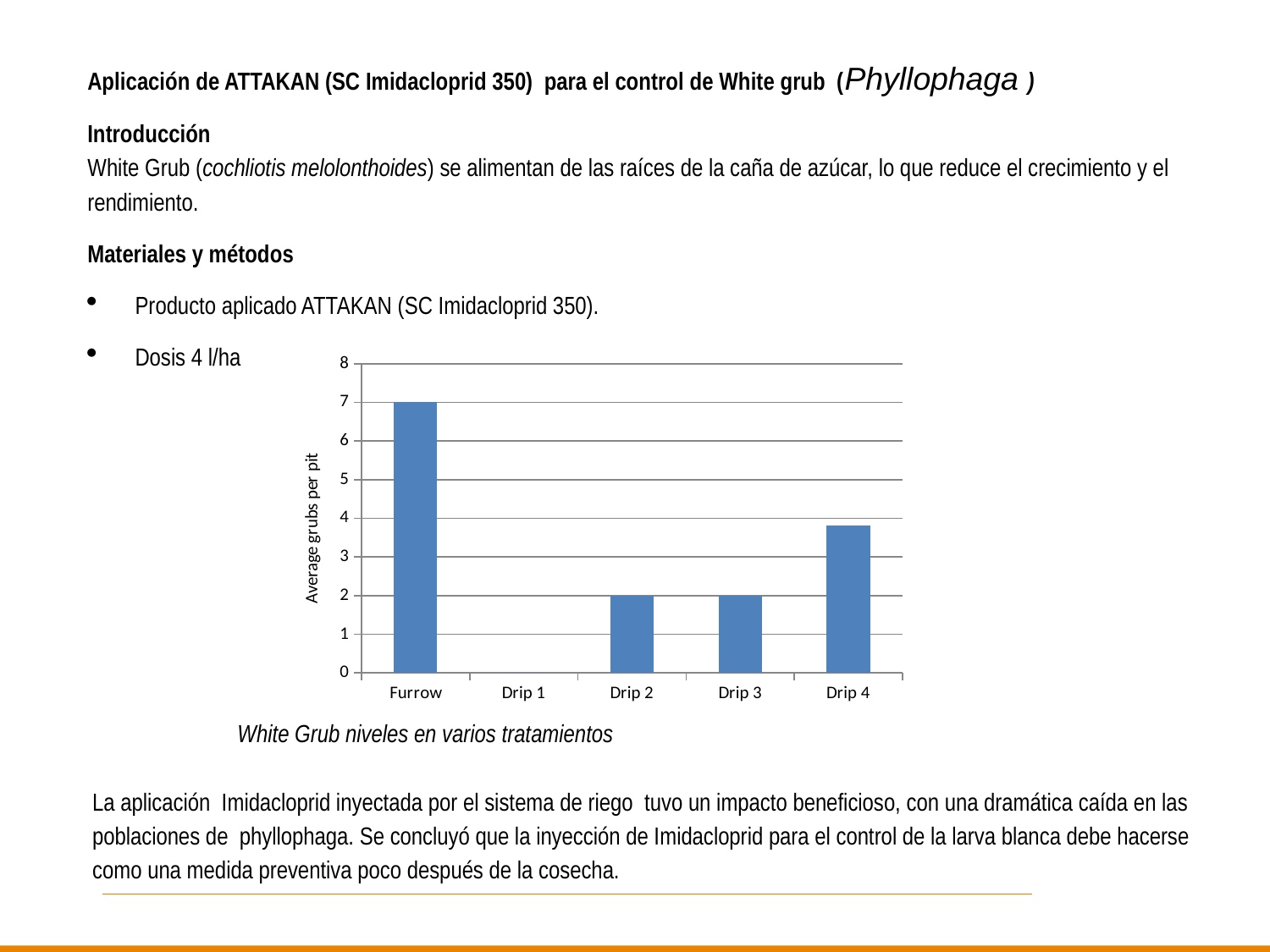
What is the value for Drip 3? 2 What is the label of the vertical axis? Average grubs per pit What is the difference between the values for Furrow and Drip 2? 5 What kind of chart is shown on the slide? Bar chart Is the value for Drip 4 greater or less than 4? less Which category has the lowest average grubs per pit? Drip 1 Which category has the highest average grubs per pit? Furrow What is the value for Furrow? 7 How many categories are shown on the x axis? 5 Which is larger, the value for Furrow or the value for Drip 4? Furrow Is the value for Drip 4 greater or less than 3? greater What is the value for Drip 2? 2